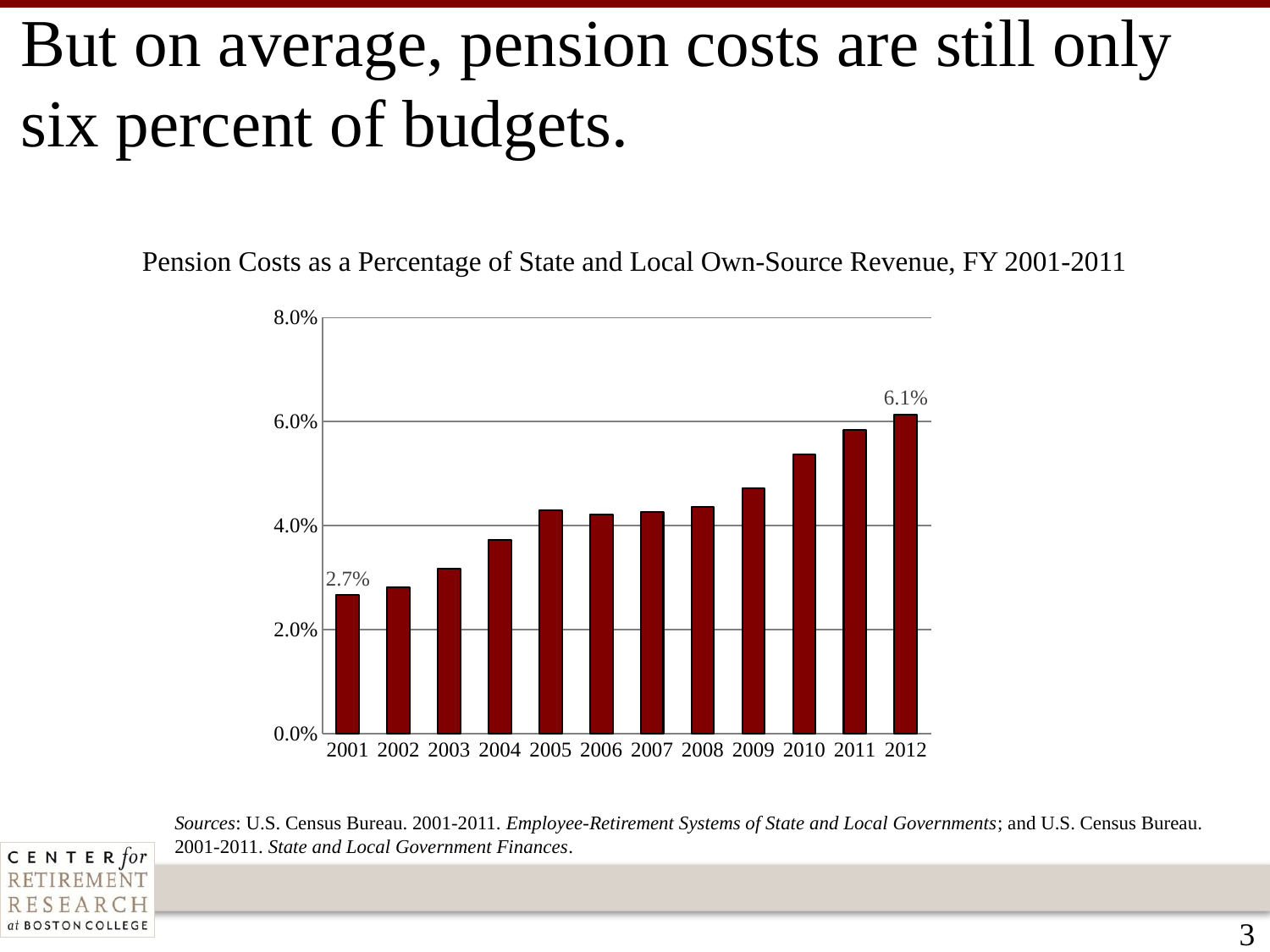
What is the value shown for 2001? 2.7% What kind of chart is shown on the slide? Bar chart Do the values generally rise or fall from 2001 to 2012? Rise Which year has the lowest pension cost percentage? 2001 Is the value for 2010 greater or less than 4.0%? greater Is the value for 2004 greater or less than 4.0%? less Is the value for 2003 greater or less than 2.0%? greater What is the value shown for 2012? 6.1% How many years are plotted on the chart? 12 Which year has the highest pension cost percentage? 2012 By how many percentage points does the 2012 value exceed the 2001 value? 3.4 percentage points Which year has the larger value, 2005 or 2010? 2010